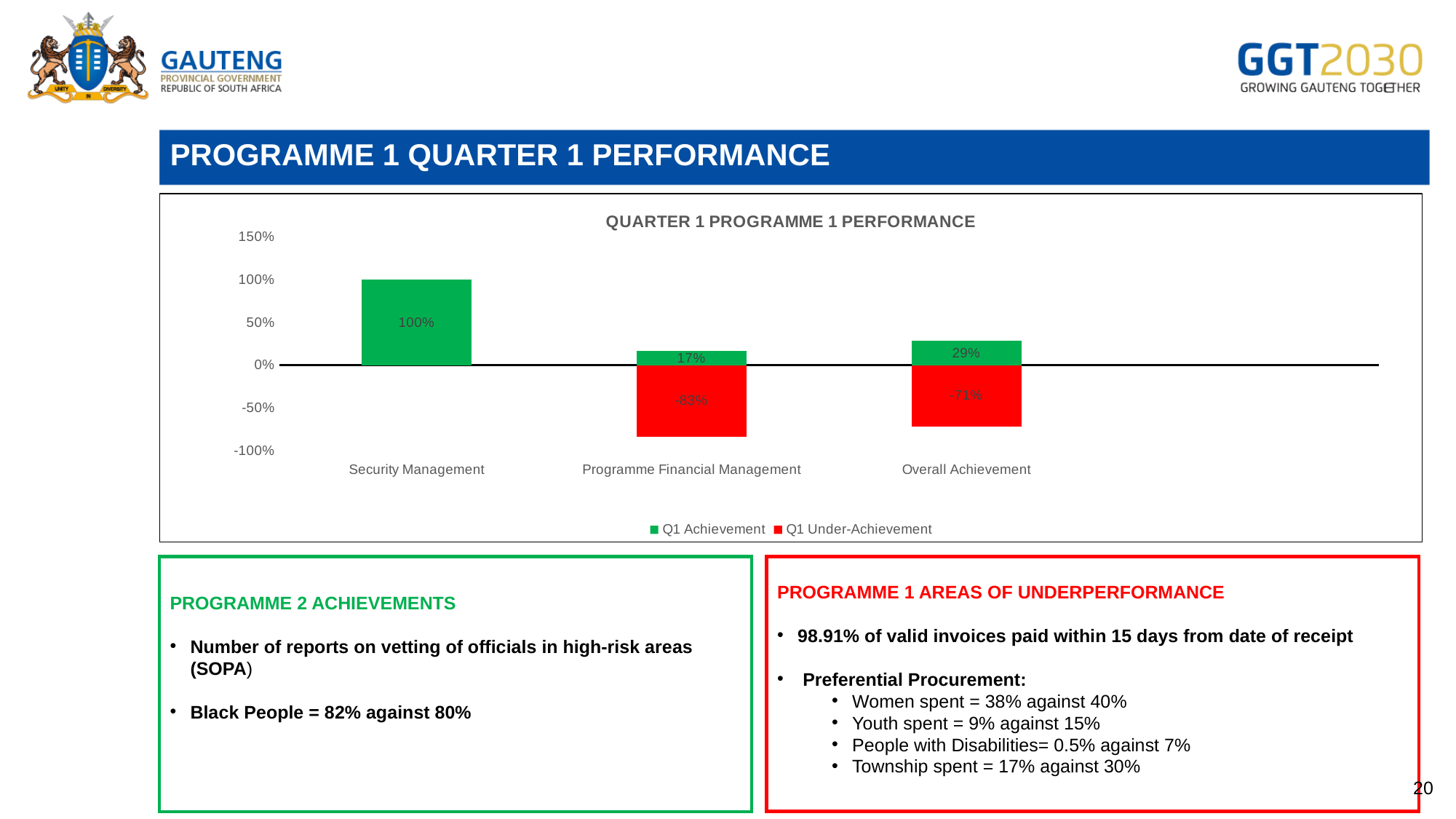
What is the difference between the Q1 Achievement values for Overall Achievement and Programme Financial Management? 12% What is the Q1 Under-Achievement value for Overall Achievement? -71% What is the Q1 Achievement value for Programme Financial Management? 17% What is the Q1 Achievement value for Security Management? 100% What is the Q1 Achievement value for Overall Achievement? 29% What type of chart is shown on the slide? Bar chart Which has a larger Q1 Achievement value, Security Management or Overall Achievement? Security Management Which category has the lowest Q1 Achievement value? Programme Financial Management How many series does the chart legend list? 2 How many categories are shown on the x axis of the chart? 3 What is the Q1 Under-Achievement value for Programme Financial Management? -83% Which category has the highest Q1 Achievement value? Security Management